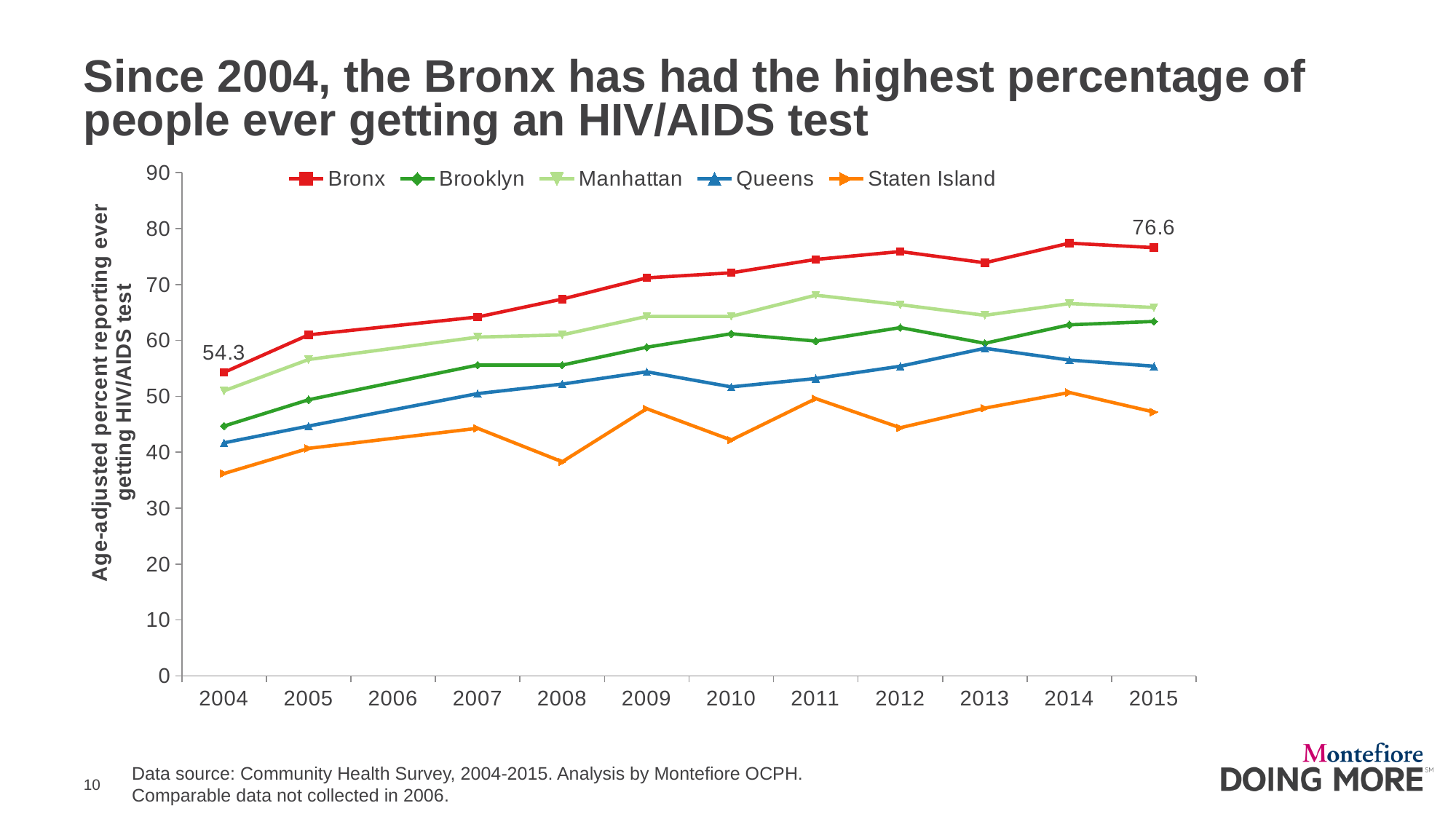
How many series does the legend list? 5 What kind of chart is shown on the slide? Line chart Is the value for Manhattan in 2011 greater or less than 60? greater Does the Bronx line rise or fall from 2004 to 2015? rise How many years are labeled on the x axis? 12 By how much did the Bronx value increase from 2004 to 2015? 22.3 Which borough has the lowest value in 2004? Staten Island In 2010, which is larger, the value for Brooklyn or the value for Queens? Brooklyn What is the value for the Bronx in 2004? 54.3 Is the value for Staten Island in 2004 greater or less than 40? less Which borough has the highest value in 2015? Bronx What is the value for the Bronx in 2015? 76.6